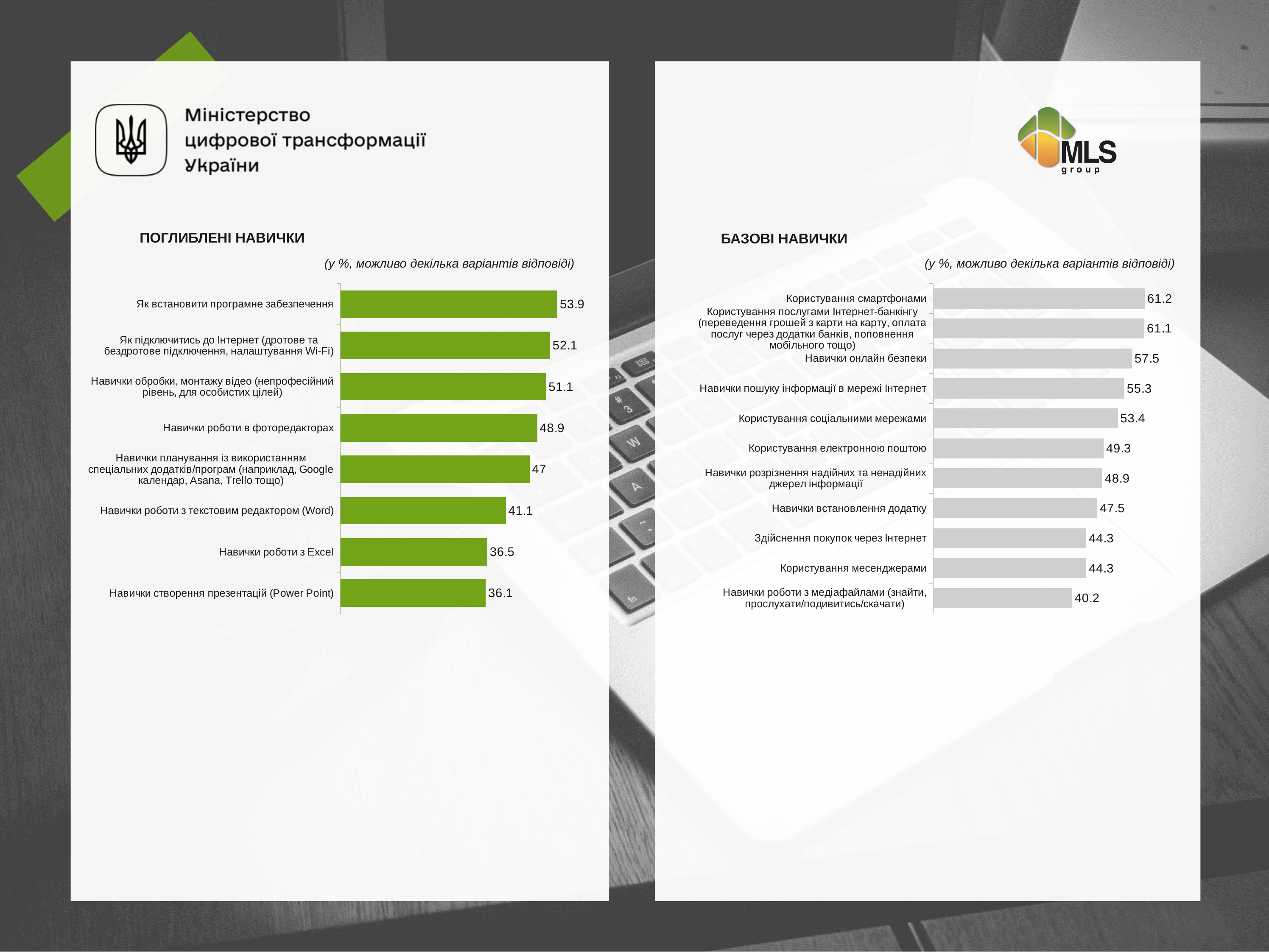
What type of chart is the 'БАЗОВІ НАВИЧКИ' chart? Bar chart In the 'ПОГЛИБЛЕНІ НАВИЧКИ' chart, how many categories are shown? 8 In the 'БАЗОВІ НАВИЧКИ' chart, which is larger: 'Користування електронною поштою' or 'Навички встановлення додатку'? Користування електронною поштою In the 'БАЗОВІ НАВИЧКИ' chart, what is the difference between 'Користування смартфонами' and 'Користування соціальними мережами'? 7.8 In the 'ПОГЛИБЛЕНІ НАВИЧКИ' chart, which category has the highest value? Як встановити програмне забезпечення In the 'ПОГЛИБЛЕНІ НАВИЧКИ' chart, which category has the lowest value? Навички створення презентацій (Power Point) In the 'ПОГЛИБЛЕНІ НАВИЧКИ' chart, what is the difference between 'Навички роботи в фоторедакторах' and 'Навички роботи з текстовим редактором (Word)'? 7.8 In the 'БАЗОВІ НАВИЧКИ' chart, what is the value for 'Навички онлайн безпеки'? 57.5 In the 'БАЗОВІ НАВИЧКИ' chart, which category has the lowest value? Навички роботи з медіафайлами (знайти, прослухати/подивитись/скачати) What colour are the bars in the 'ПОГЛИБЛЕНІ НАВИЧКИ' chart? Green In the 'БАЗОВІ НАВИЧКИ' chart, how many categories are shown? 11 In the 'ПОГЛИБЛЕНІ НАВИЧКИ' chart, what is the value for 'Навички роботи з Excel'? 36.5